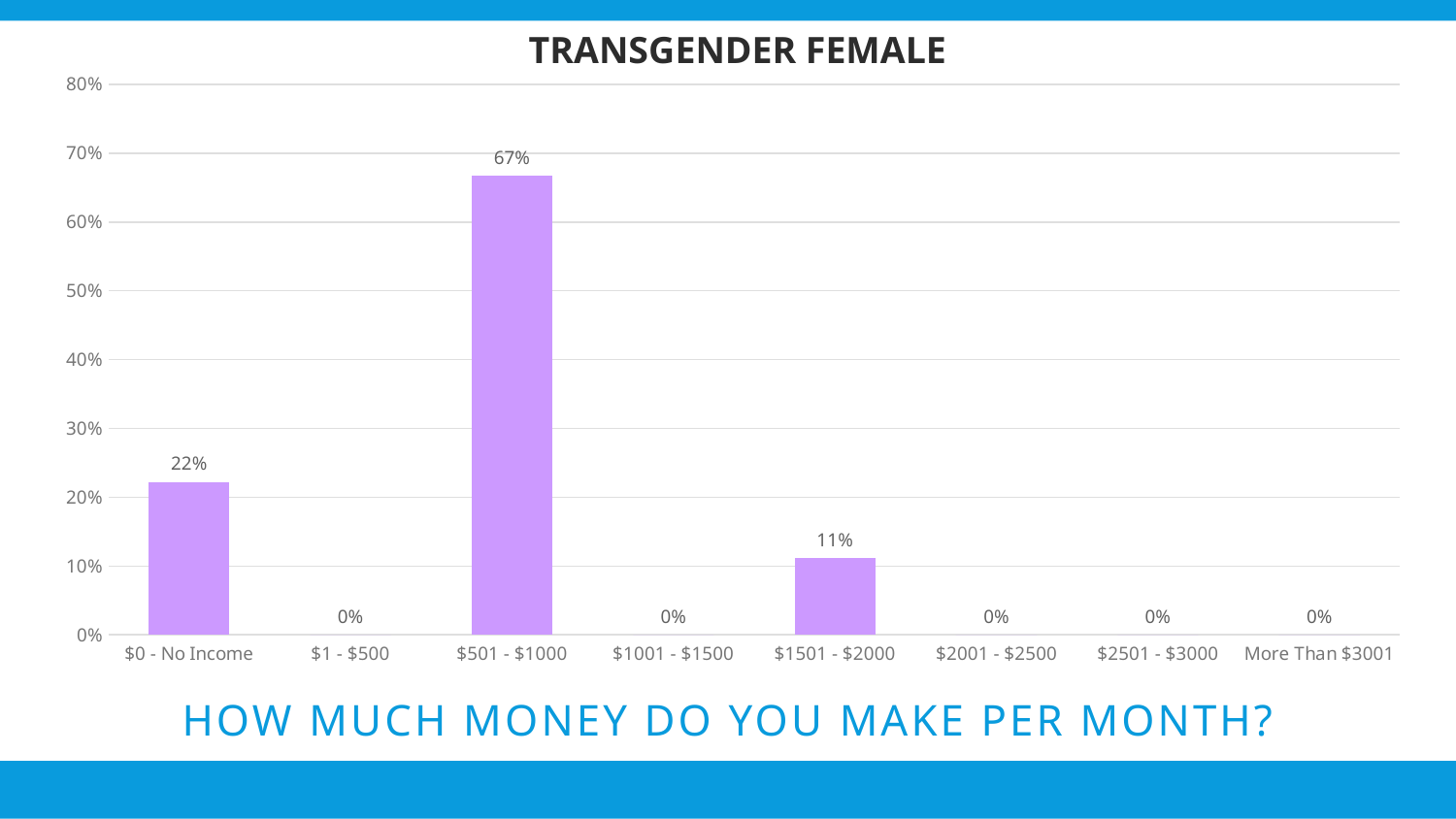
What is the difference between the $501 - $1000 value and the $0 - No Income value? 45% Is the value for $501 - $1000 greater or less than 60%? greater Which is larger, the value for $0 - No Income or the value for $1501 - $2000? $0 - No Income What is the title of the chart? TRANSGENDER FEMALE What is the value for the $0 - No Income category? 22% What percentage of respondents reported making $501 - $1000 per month? 67% What type of chart is shown on the slide? Bar chart What is the difference between the $0 - No Income value and the $1501 - $2000 value? 11% What percentage is shown for the $1501 - $2000 category? 11% How many income categories are shown on the x axis? 8 Which income category has the highest percentage? $501 - $1000 What is the value for the More Than $3001 category? 0%